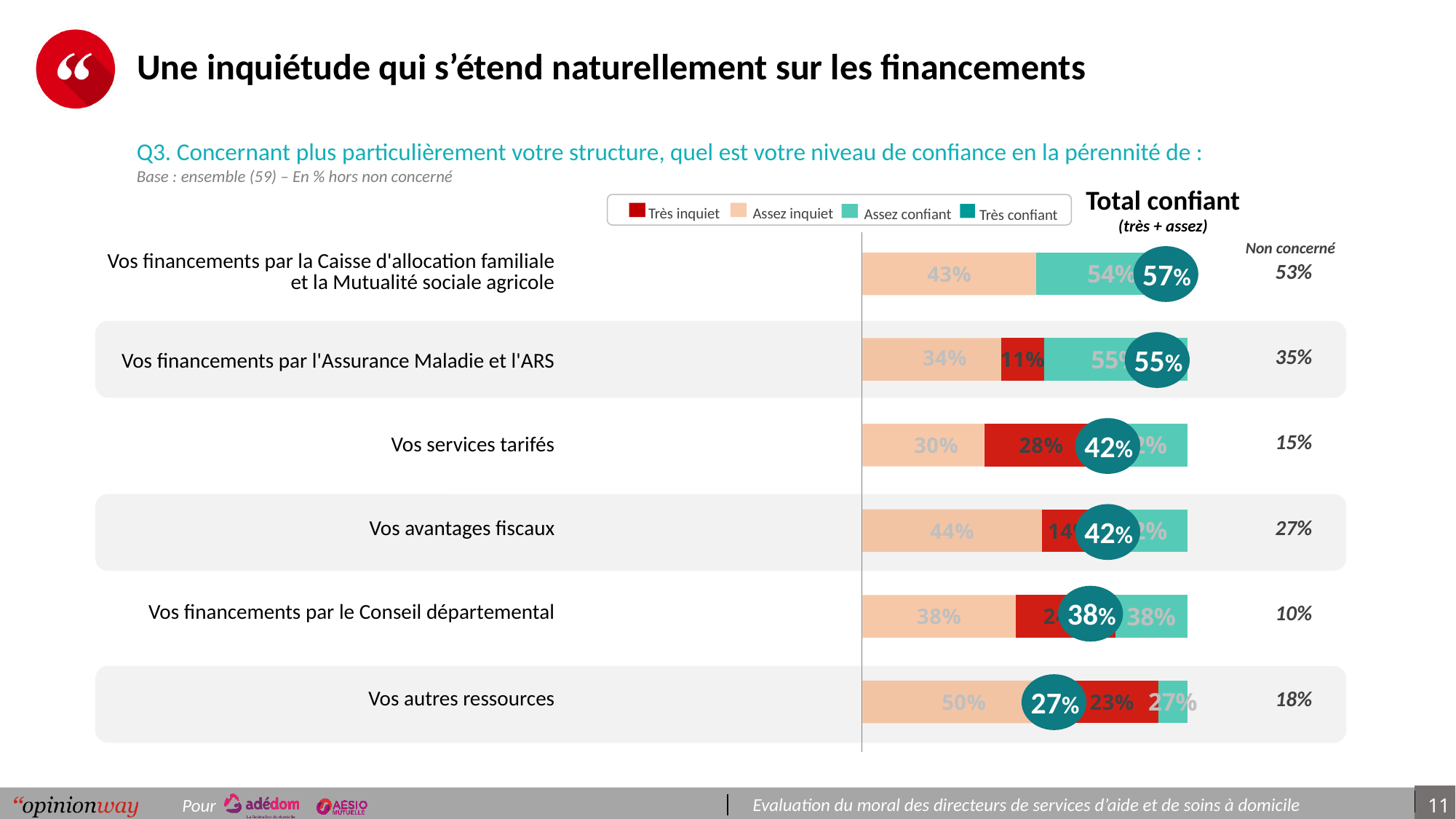
Which is larger: the 'Très inquiet' value for 'Vos services tarifés' or for 'Vos financements par l'Assurance Maladie et l'ARS'? Vos services tarifés How many series does the legend list? 4 Which category has the highest 'Total confiant' value? Vos financements par la Caisse d'allocation familiale et la Mutualité sociale agricole What is the 'Total confiant' value for 'Vos financements par la Caisse d'allocation familiale et la Mutualité sociale agricole'? 57% What is the difference in 'Total confiant' between 'Vos financements par la Caisse d'allocation familiale et la Mutualité sociale agricole' and 'Vos autres ressources'? 30 points Which category has the lowest 'Total confiant' value? Vos autres ressources What is the 'Très inquiet' value for 'Vos services tarifés'? 28% What type of chart is shown on the slide? Stacked bar chart Which category has the lowest 'Non concerné' value? Vos financements par le Conseil départemental How many categories (rows) are plotted in the chart? 6 What is the 'Assez inquiet' value for 'Vos autres ressources'? 50% What is the 'Non concerné' value for 'Vos financements par l'Assurance Maladie et l'ARS'? 35%